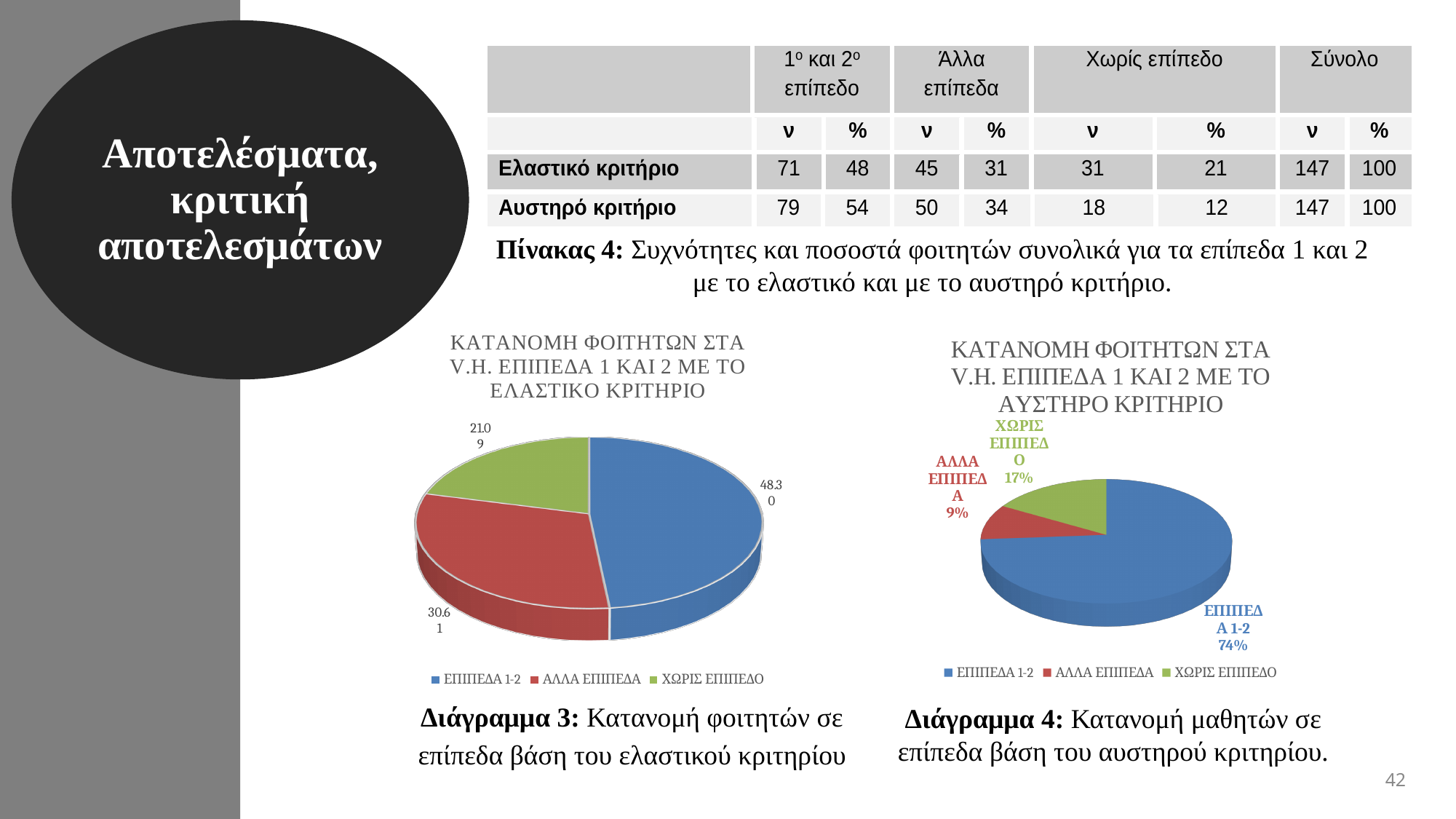
How many categories does the legend of the left pie chart (ΕΛΑΣΤΙΚΟ ΚΡΙΤΗΡΙΟ) list? 3 In the left pie chart (ΕΛΑΣΤΙΚΟ ΚΡΙΤΗΡΙΟ), which category has the largest slice? ΕΠΙΠΕΔΑ 1-2 In the right pie chart (ΑΥΣΤΗΡΟ ΚΡΙΤΗΡΙΟ), what colour is the ΧΩΡΙΣ ΕΠΙΠΕΔΟ slice? green In the right pie chart (ΑΥΣΤΗΡΟ ΚΡΙΤΗΡΙΟ), what share is labelled for ΕΠΙΠΕΔΑ 1-2? 74% In the right pie chart (ΑΥΣΤΗΡΟ ΚΡΙΤΗΡΙΟ), what share is labelled for ΑΛΛΑ ΕΠΙΠΕΔΑ? 9% In the right pie chart (ΑΥΣΤΗΡΟ ΚΡΙΤΗΡΙΟ), what share is labelled for ΧΩΡΙΣ ΕΠΙΠΕΔΟ? 17% In the right pie chart (ΑΥΣΤΗΡΟ ΚΡΙΤΗΡΙΟ), what is the difference between the ΕΠΙΠΕΔΑ 1-2 share and the ΧΩΡΙΣ ΕΠΙΠΕΔΟ share? 57% In the left pie chart (ΕΛΑΣΤΙΚΟ ΚΡΙΤΗΡΙΟ), which slice is larger: ΑΛΛΑ ΕΠΙΠΕΔΑ or ΧΩΡΙΣ ΕΠΙΠΕΔΟ? ΑΛΛΑ ΕΠΙΠΕΔΑ In the left pie chart (ΕΛΑΣΤΙΚΟ ΚΡΙΤΗΡΙΟ), which category has the smallest slice? ΧΩΡΙΣ ΕΠΙΠΕΔΟ What kind of chart is the left chart (ΕΛΑΣΤΙΚΟ ΚΡΙΤΗΡΙΟ)? pie chart In the right pie chart (ΑΥΣΤΗΡΟ ΚΡΙΤΗΡΙΟ), which category has the smallest slice? ΑΛΛΑ ΕΠΙΠΕΔΑ In the right pie chart (ΑΥΣΤΗΡΟ ΚΡΙΤΗΡΙΟ), which category has the largest slice? ΕΠΙΠΕΔΑ 1-2